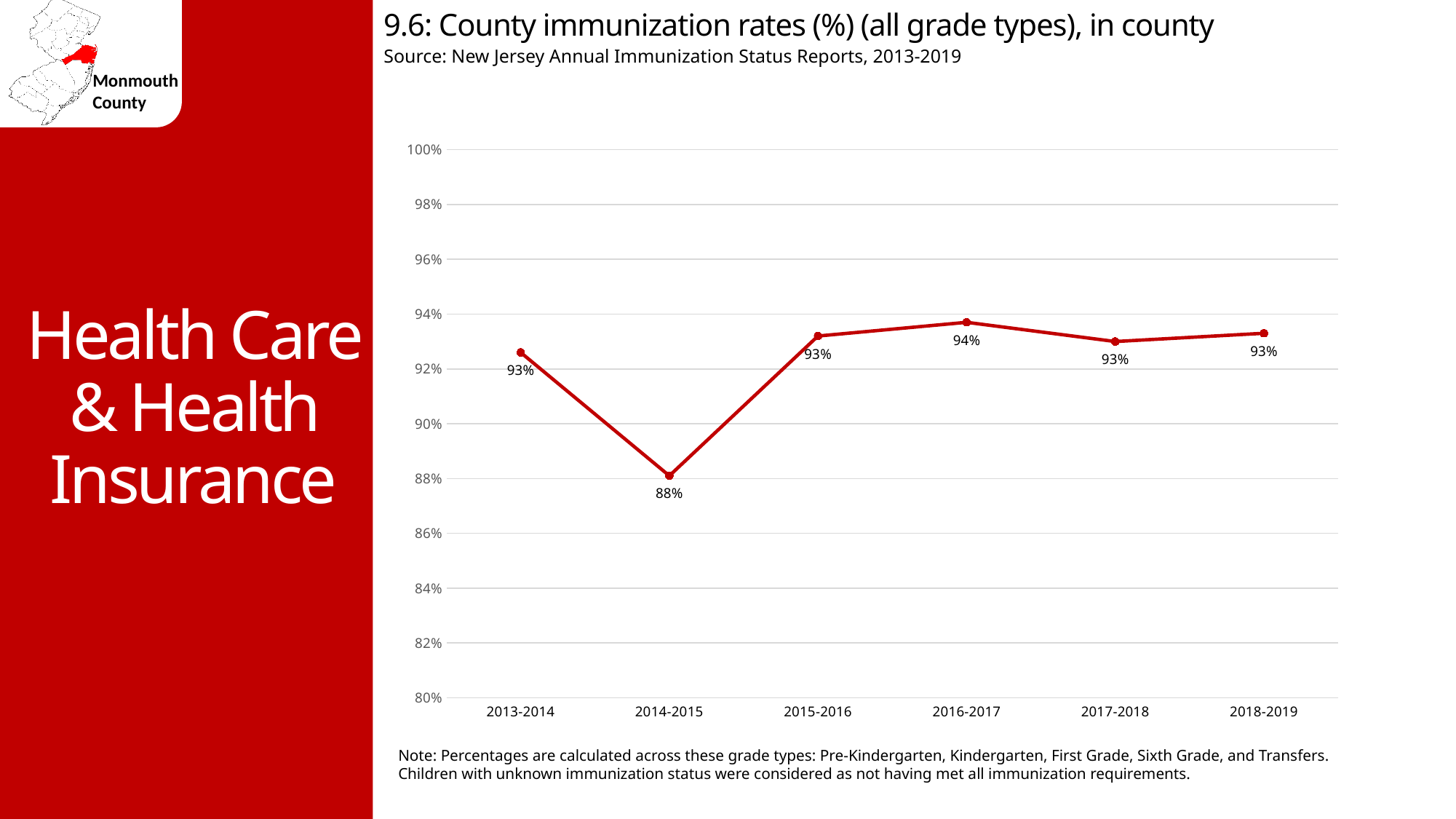
Which school year had the highest immunization rate? 2016-2017 What was the county immunization rate in 2016-2017? 94% How many school years are plotted on the chart? 6 What kind of chart is shown on the slide? line chart Is the value for 2014-2015 greater or less than 90%? less What is the difference between the immunization rate in 2016-2017 and in 2014-2015? 6 percentage points Which year had a higher immunization rate, 2013-2014 or 2014-2015? 2013-2014 Did the immunization rate rise or fall from 2014-2015 to 2016-2017? rise What is the source cited for the chart? New Jersey Annual Immunization Status Reports, 2013-2019 What was the county immunization rate in 2018-2019? 93% Which school year had the lowest immunization rate? 2014-2015 What was the county immunization rate in 2014-2015? 88%